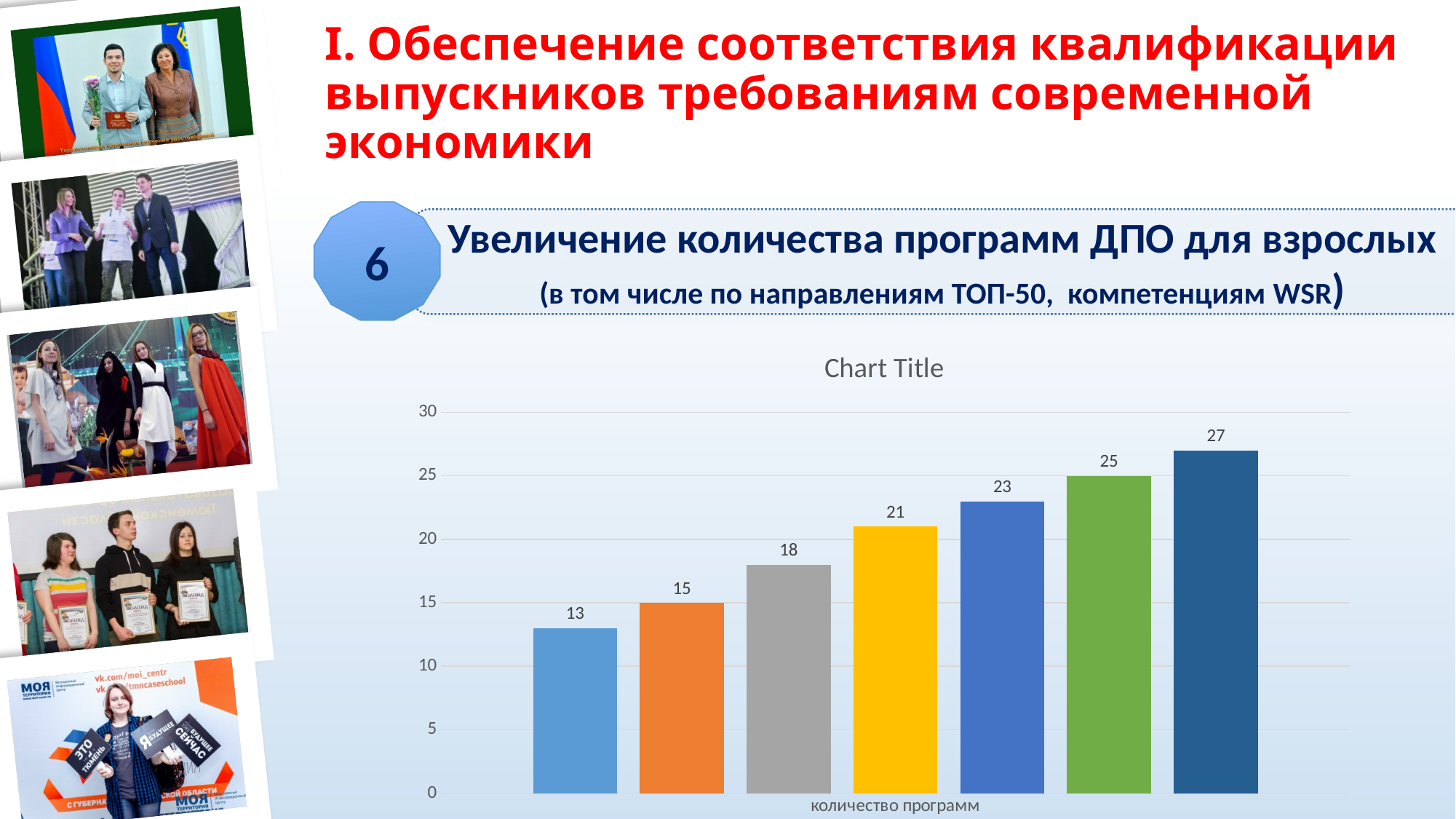
What is the value of the yellow bar? 21 What is the value of the first (leftmost, light blue) bar? 13 What is the difference between the last (dark blue) bar and the first (light blue) bar? 14 What is the title displayed above the chart? Chart Title What is the value of the orange bar? 15 What is the value of the green bar? 25 Do the bar values rise or fall from left to right? rise What is the value of the grey bar? 18 What is the lowest value shown in the chart? 13 What type of chart is shown on the slide? bar chart How many bars are plotted in the chart? 7 What is the highest value shown in the chart? 27